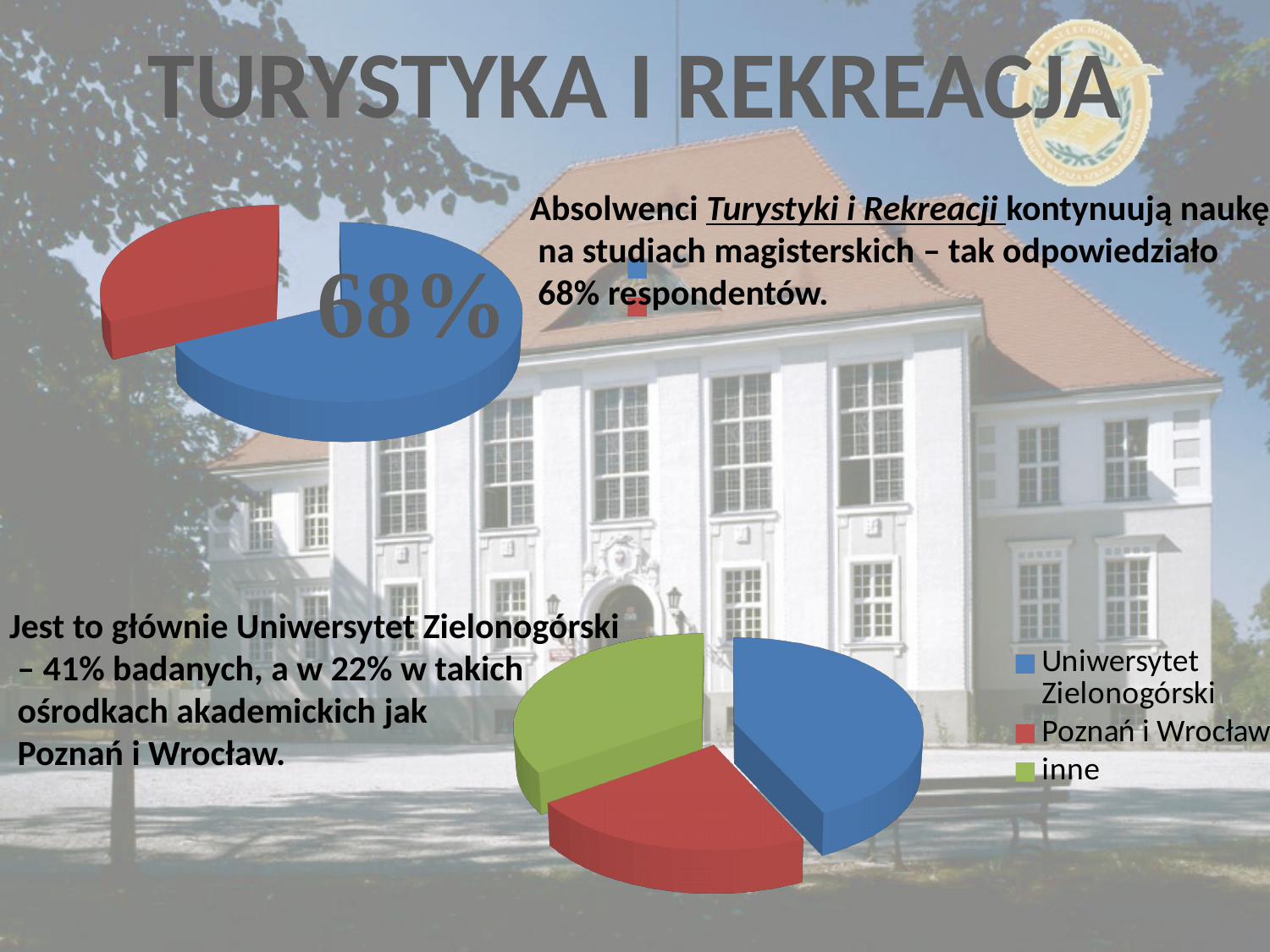
In the bottom pie chart, which slice is larger, Uniwersytet Zielonogórski or Poznań i Wrocław? Uniwersytet Zielonogórski How many slices does the top-left pie chart have? 2 In the bottom pie chart, which category is shown in blue? Uniwersytet Zielonogórski In the top-left pie chart, what percentage is printed on the chart? 68% In the bottom pie chart, which colour represents the category 'inne'? green What kind of chart is the chart at the bottom of the slide? pie chart In the bottom pie chart, which category has the smallest slice? Poznań i Wrocław In the top-left pie chart, what share of the pie does the blue slice represent? 68% How many slices does the bottom pie chart have? 3 How many entries does the legend of the bottom pie chart list? 3 In the top-left pie chart, which slice is larger, the blue one or the red one? the blue one What kind of chart is the chart in the top-left of the slide? pie chart